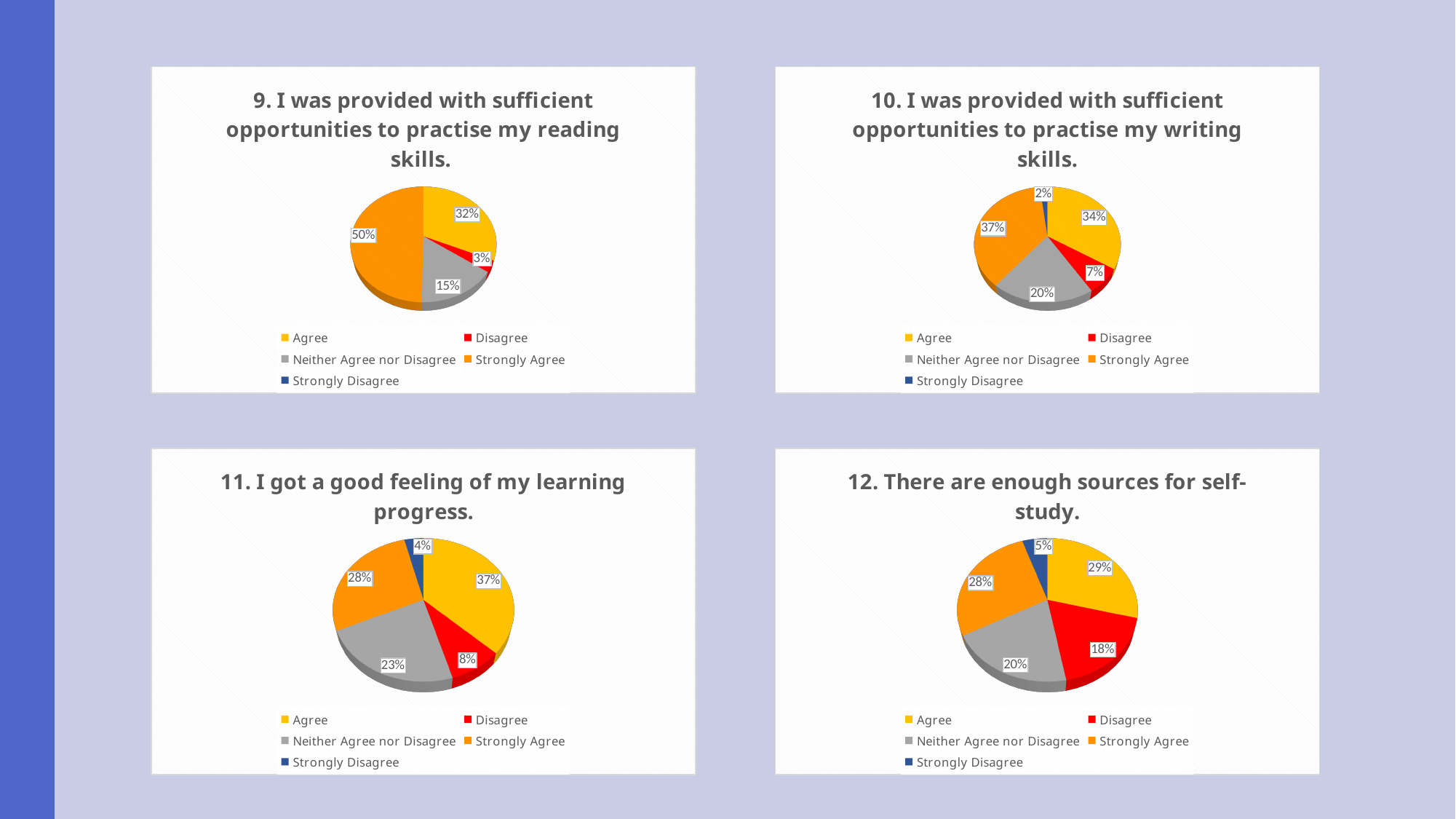
In the chart titled "10. I was provided with sufficient opportunities to practise my writing skills.", which category has the largest slice? Strongly Agree In the chart titled "9. I was provided with sufficient opportunities to practise my reading skills.", what share of the pie is Strongly Agree? 50% In the chart titled "10. I was provided with sufficient opportunities to practise my writing skills.", what is the value for Strongly Disagree? 2% In the chart titled "11. I got a good feeling of my learning progress.", which is larger, Agree or Strongly Agree? Agree In the chart titled "9. I was provided with sufficient opportunities to practise my reading skills.", what is the value for Disagree? 3% In the chart titled "12. There are enough sources for self-study.", what is the difference between Agree and Strongly Disagree? 24% What kind of chart is the chart titled "12. There are enough sources for self-study."? Pie chart In the chart titled "12. There are enough sources for self-study.", what is the value for Disagree? 18% How many entries does the legend list in the chart titled "9. I was provided with sufficient opportunities to practise my reading skills."? 5 In the chart titled "10. I was provided with sufficient opportunities to practise my writing skills.", what is the difference between Agree and Neither Agree nor Disagree? 14% In the chart titled "11. I got a good feeling of my learning progress.", what is the value for Neither Agree nor Disagree? 23% In the chart titled "11. I got a good feeling of my learning progress.", which category has the smallest slice? Strongly Disagree